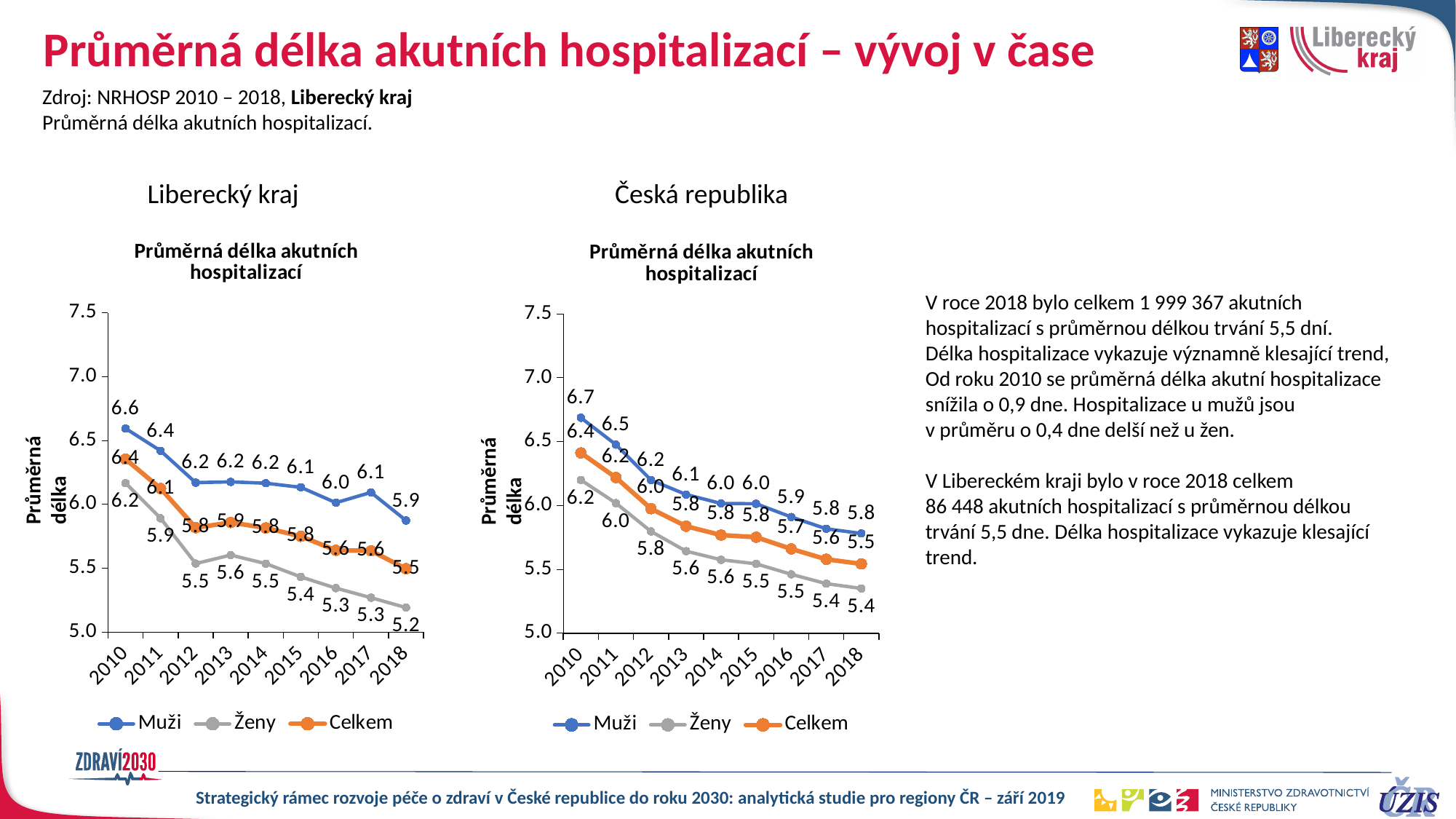
How many series does the legend of the Česká republika chart list? 3 In the Liberecký kraj chart, what is the difference between the Muži value in 2010 and the Muži value in 2018? 0.7 What kind of chart is the Liberecký kraj chart? Line chart In the Česká republika chart, in which year is the Ženy series lowest? 2017 and 2018 (both 5.4) In the Liberecký kraj chart, in which year is the Muži series highest? 2010 In the Liberecký kraj chart, what is the value for Ženy in 2018? 5.2 How many years are shown on the x axis of the Liberecký kraj chart? 9 In the Česká republika chart, what is the value for Celkem in 2018? 5.5 In the Česká republika chart, does the Celkem series rise or fall from 2010 to 2018? Fall In the Česká republika chart, what is the value for Muži in 2010? 6.7 In the Liberecký kraj chart, what is the value for Muži in 2010? 6.6 In the Česká republika chart, which is larger in 2013: the Muži value or the Ženy value? Muži